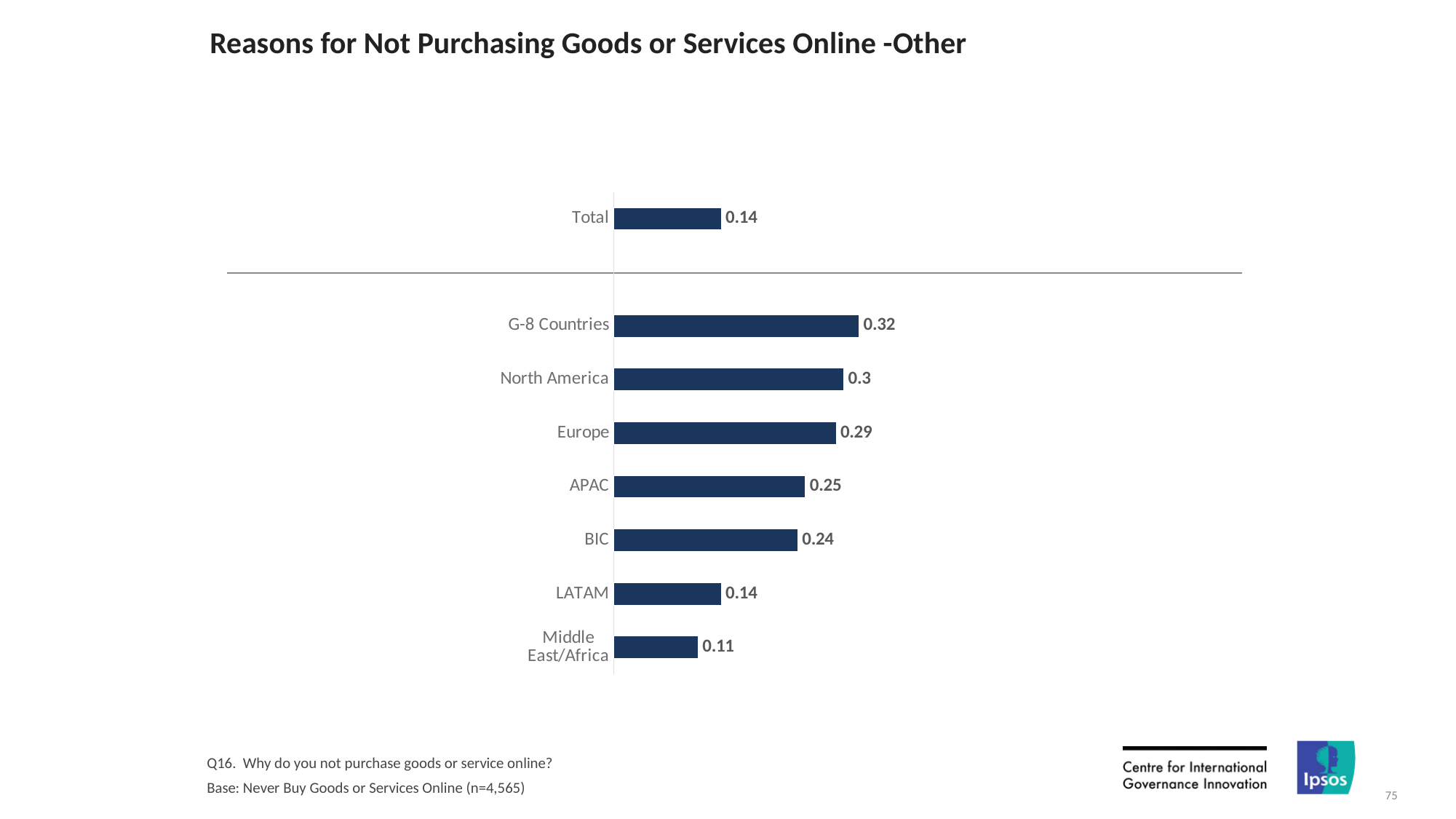
What kind of chart is shown on the slide? Bar chart What is the value for Middle East/Africa? 0.11 What is the value for Total? 0.14 What is the difference between the values for G-8 Countries and LATAM? 0.18 What is the value for G-8 Countries? 0.32 Which region has the highest value? G-8 Countries Which is larger, the value for APAC or the value for LATAM? APAC What is the difference between the values for North America and Europe? 0.01 What is the value for BIC? 0.24 Which region has the lowest value? Middle East/Africa What is the title of the chart? Reasons for Not Purchasing Goods or Services Online -Other How many bars are plotted on the chart? 8